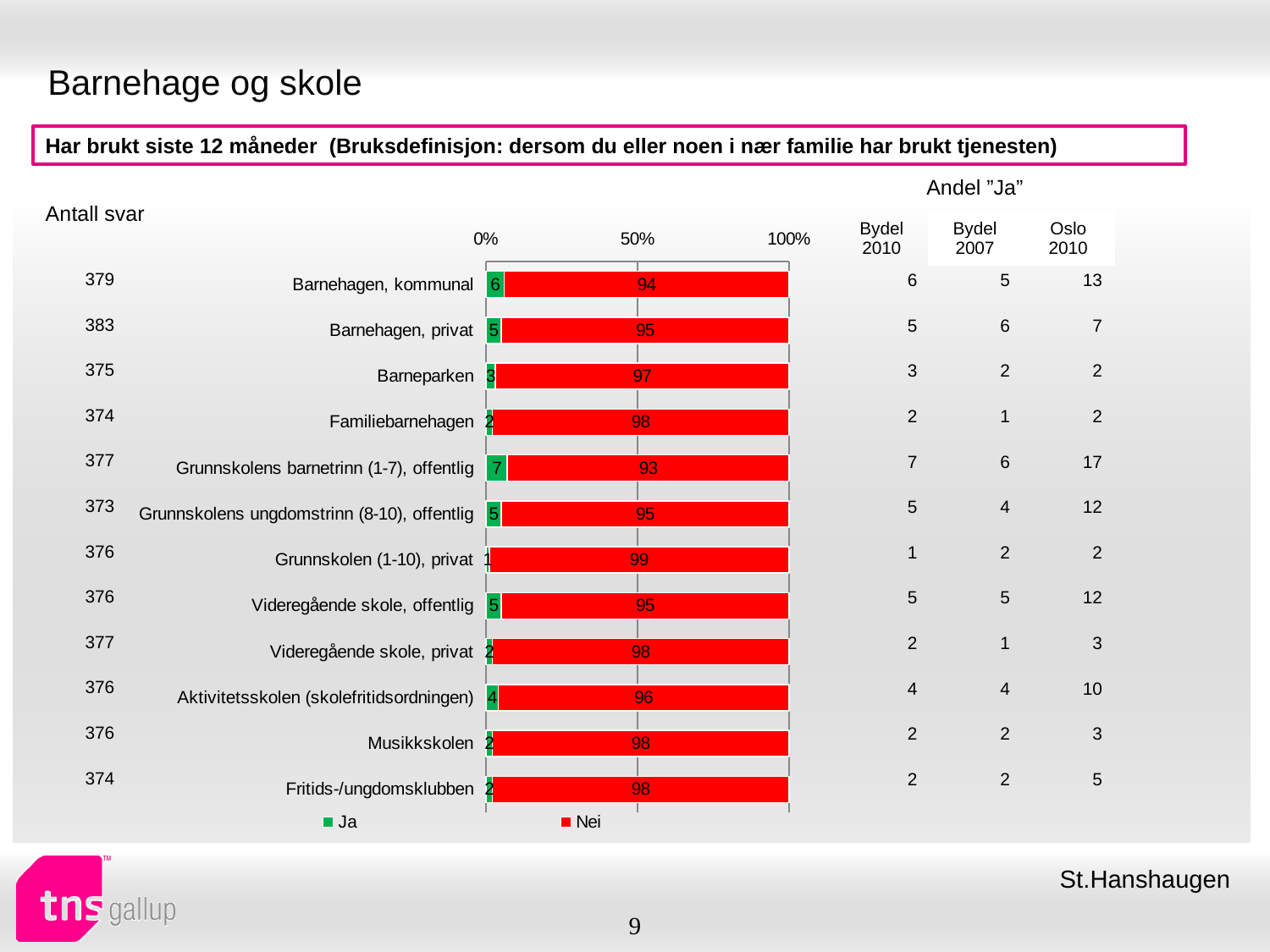
What is the "Ja" value for Grunnskolens barnetrinn (1-7), offentlig? 7 What is the "Nei" value for Barnehagen, kommunal? 94 How many categories are shown in the chart? 12 What is the total of the stacked bar for Musikkskolen? 100 Which category has the highest "Ja" value? Grunnskolens barnetrinn (1-7), offentlig How many series does the legend list? 2 What kind of chart is shown on the slide? Stacked bar chart Which is larger, the "Ja" value for Barnehagen, kommunal or for Aktivitetsskolen (skolefritidsordningen)? Barnehagen, kommunal Is the "Nei" value for Barneparken greater or less than 50%? greater What is the difference between the "Nei" values for Grunnskolen (1-10), privat and Grunnskolens barnetrinn (1-7), offentlig? 6 What is the "Nei" value for Grunnskolen (1-10), privat? 99 Which category has the lowest "Ja" value? Grunnskolen (1-10), privat